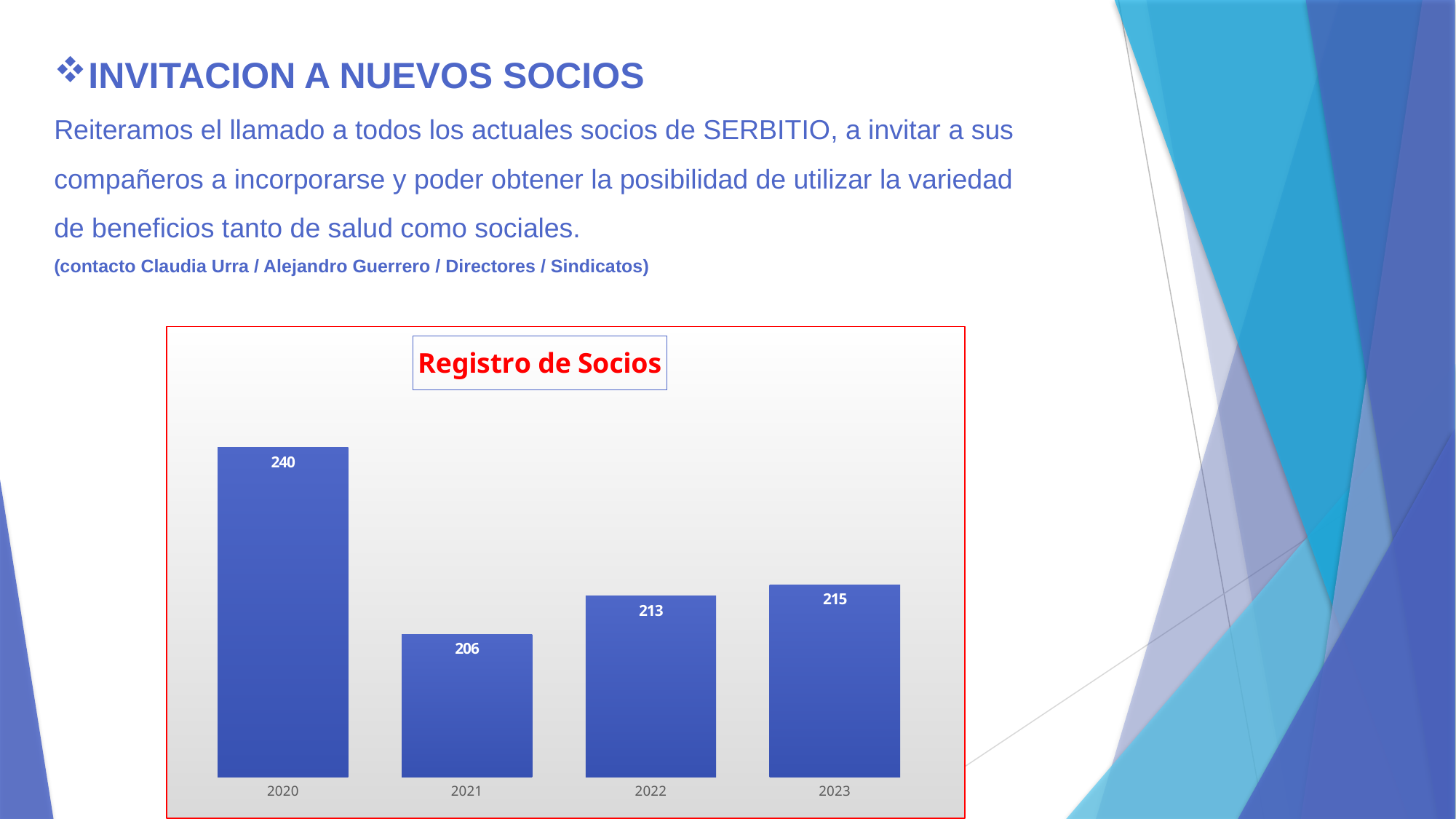
What is the value for 2020 in the Registro de Socios chart? 240 What is the difference between the values for 2023 and 2022 in the Registro de Socios chart? 2 What is the value for 2022 in the Registro de Socios chart? 213 How many years are shown in the Registro de Socios chart? 4 Which is larger in the Registro de Socios chart, the value for 2020 or the value for 2023? 2020 What is the value for 2023 in the Registro de Socios chart? 215 What is the value for 2021 in the Registro de Socios chart? 206 What kind of chart is the Registro de Socios chart? Bar chart Which year has the lowest value in the Registro de Socios chart? 2021 Which year has the highest value in the Registro de Socios chart? 2020 What is the title of the chart on the slide? Registro de Socios What is the difference between the values for 2020 and 2021 in the Registro de Socios chart? 34